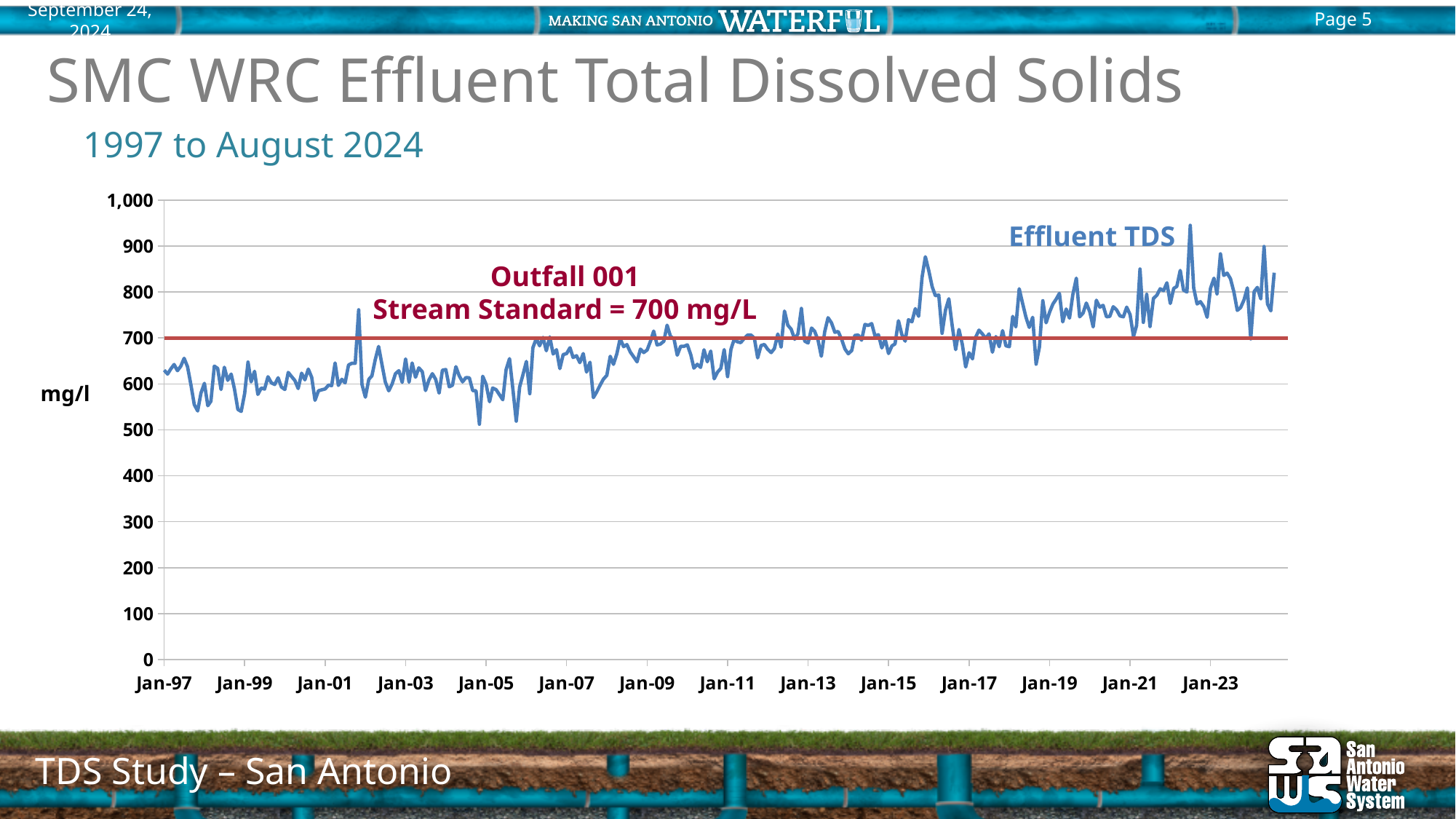
What is the name of the plotted data series on the chart? Effluent TDS What kind of chart is shown on the slide? line chart How many year labels are shown on the x-axis of the chart? 14 What is the Outfall 001 Stream Standard shown on the chart? 700 mg/L Is the Effluent TDS value at Jan-97 greater or less than 700? less Which is larger, the Effluent TDS value at Jan-97 or at Jan-23? Jan-23 What unit is shown on the y-axis of the chart? mg/l Is the Effluent TDS value at Jan-23 greater or less than 700? greater Is the highest Effluent TDS value on the chart greater or less than 900? greater Do the Effluent TDS values generally rise or fall from Jan-97 to 2024? rise